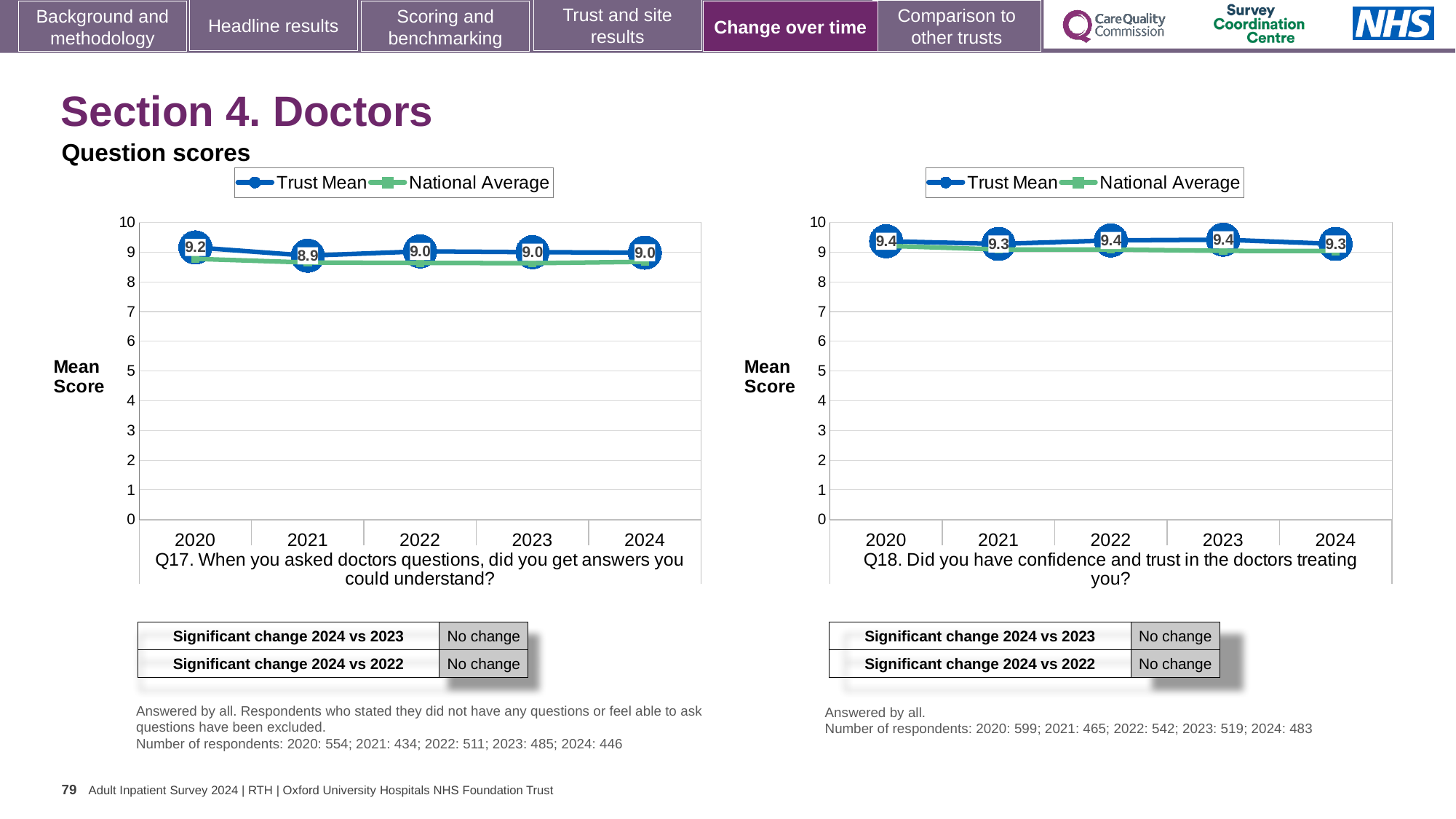
In the Q17 chart on the left, is the National Average value for 2024 greater or less than 8? greater In the Q18 chart on the right, what is the Trust Mean score for 2024? 9.3 In the Q18 chart on the right, what is the Trust Mean score for 2022? 9.4 What type of chart is the Q18 chart on the right? Line chart How many series does the legend of the Q17 chart on the left list? 2 In the Q17 chart on the left, which year has the highest Trust Mean score? 2020 In the Q17 chart on the left, which year has the lowest Trust Mean score? 2021 In the Q17 chart on the left, what is the Trust Mean score for 2020? 9.2 How many years are plotted on the x axis of the Q18 chart on the right? 5 In the Q17 chart on the left, what is the difference between the Trust Mean scores for 2020 and 2021? 0.3 In the Q18 chart on the right, is the Trust Mean score for 2020 larger or smaller than the score for 2021? larger In the Q17 chart on the left, what is the Trust Mean score for 2021? 8.9